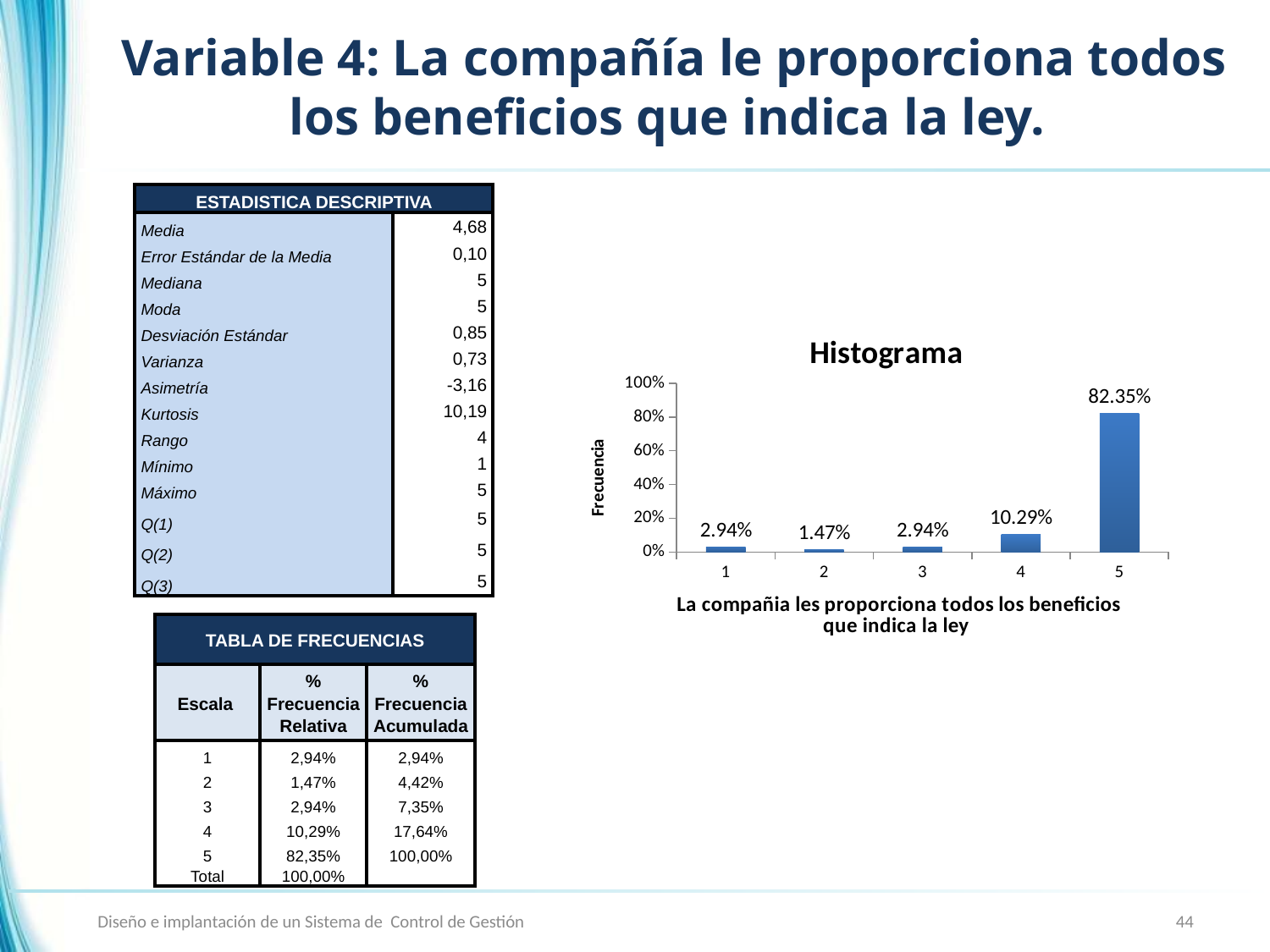
What kind of chart is the Histograma chart? bar chart Which category has the lowest value in the Histograma chart? 2 What is the value for category 4 in the Histograma chart? 10.29% What is the value for category 5 in the Histograma chart? 82.35% How many categories are shown on the x axis of the Histograma chart? 5 What is the difference between the values for category 5 and category 4 in the Histograma chart? 72.06% Which category has the highest value in the Histograma chart? 5 What is the value for category 2 in the Histograma chart? 1.47% What is the label of the y axis of the Histograma chart? Frecuencia Is the value for category 5 in the Histograma chart greater or less than 80%? greater What is the title of the chart on the slide? Histograma Which is larger in the Histograma chart, the value for category 4 or the value for category 3? category 4